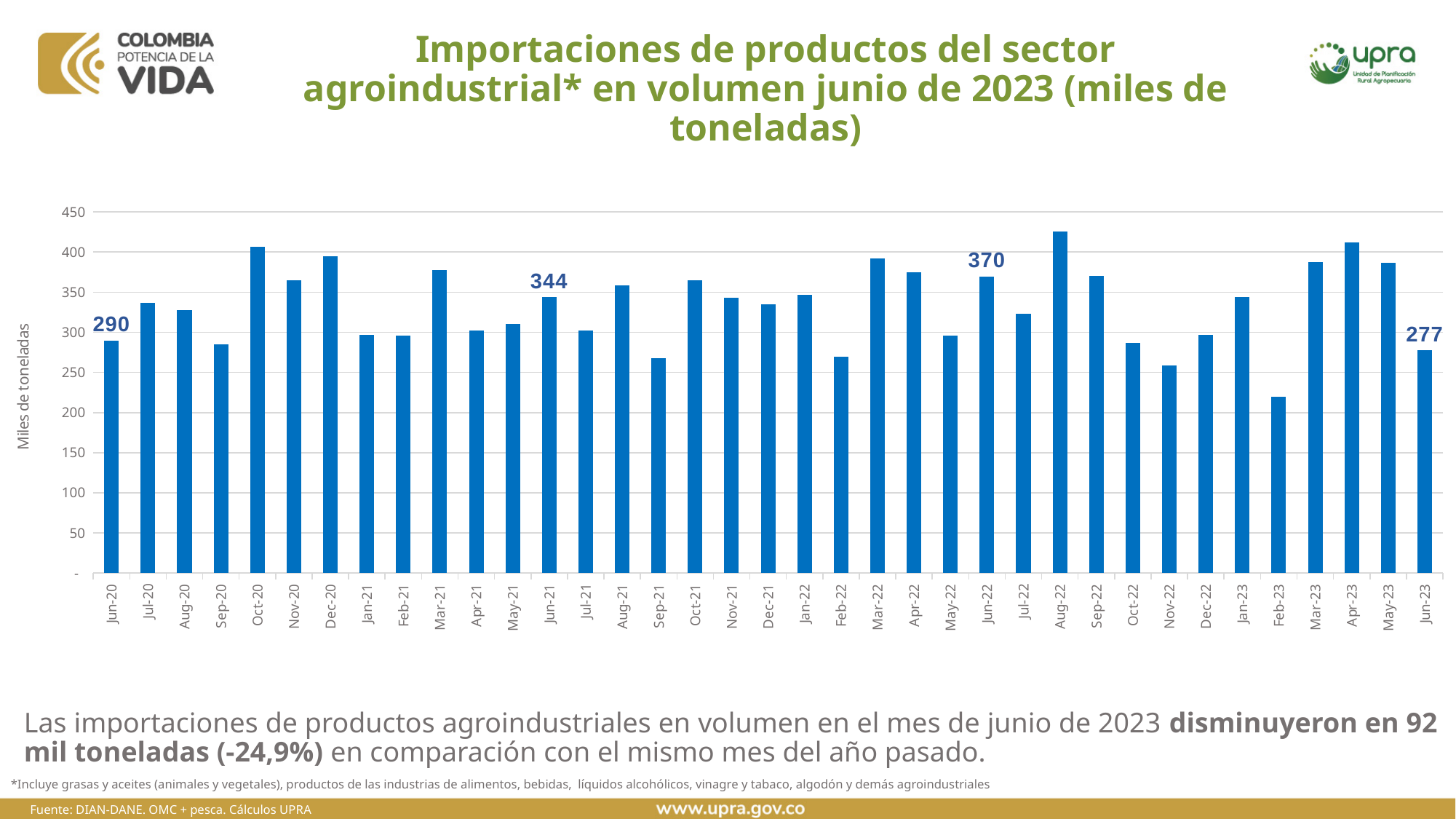
What is the difference between the values for Jun-21 and Jun-20? 54 Is the value for Aug-22 greater or less than 400? greater What is the value for Jun-23? 277 Which month has the highest bar? Aug-22 Is the value for Feb-23 greater or less than 250? less What is the value for Jun-22? 370 How many monthly bars are plotted in the chart? 37 What is the value for Jun-21? 344 Which is larger, the value for Jun-22 or the value for Jun-21? Jun-22 What is the value for Jun-20? 290 Which month has the lowest bar? Feb-23 What kind of chart is shown on the slide? bar chart